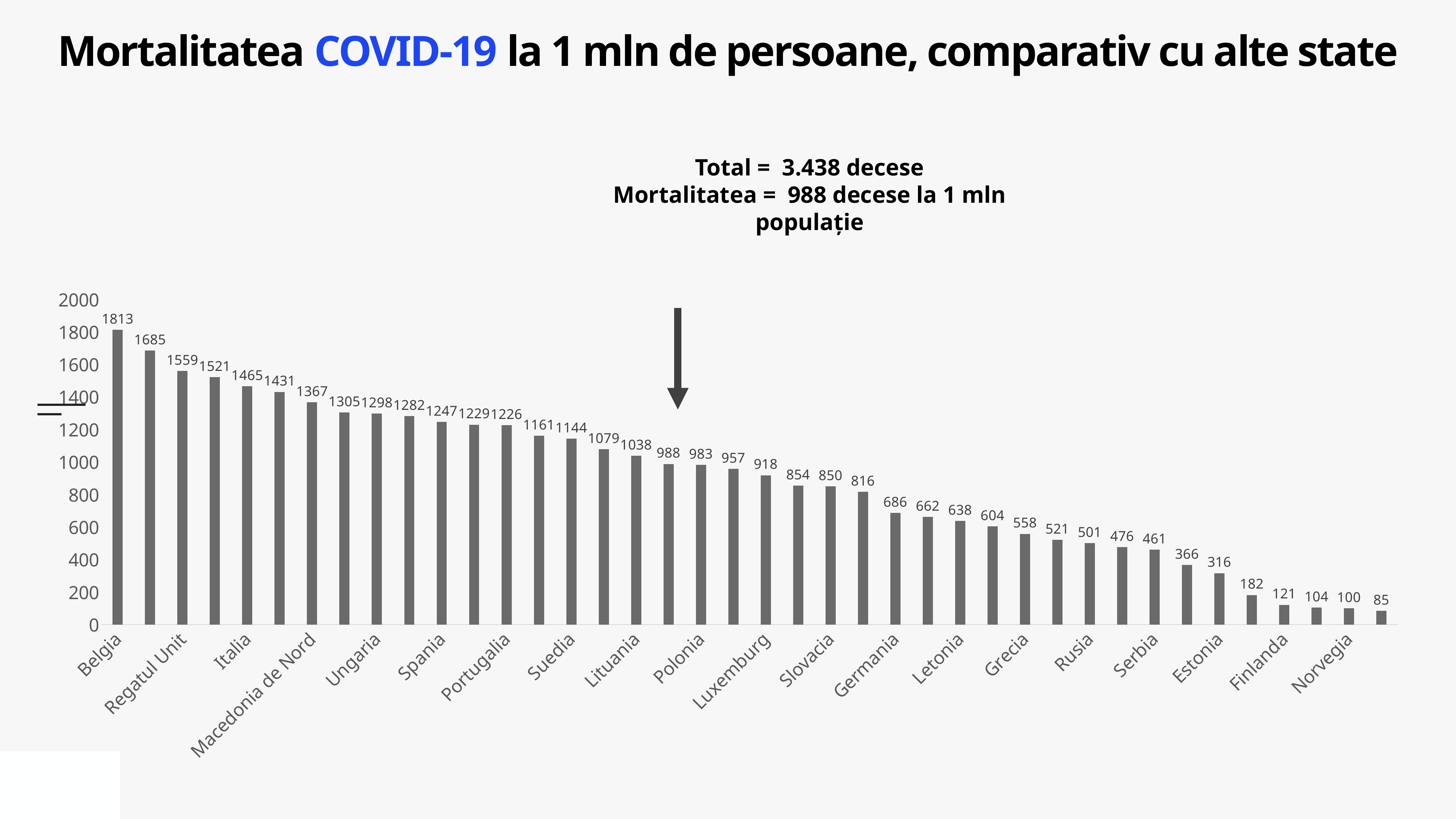
Do the values rise or fall from left to right along the x axis? fall What is the difference between the values for Belgia and Norvegia? 1713 Which has a higher value, Spania or Italia? Italia What kind of chart is shown on the slide? bar chart What is the value shown for Belgia? 1813 What is the value of the lowest bar in the chart? 85 Is the value for Estonia greater or less than 400? less What is the value shown for Norvegia? 100 What is the value shown for Germania? 686 How many bars are plotted in the chart? 40 Which country has the highest COVID-19 mortality per 1 million people in the chart? Belgia What is the value shown for Polonia? 983